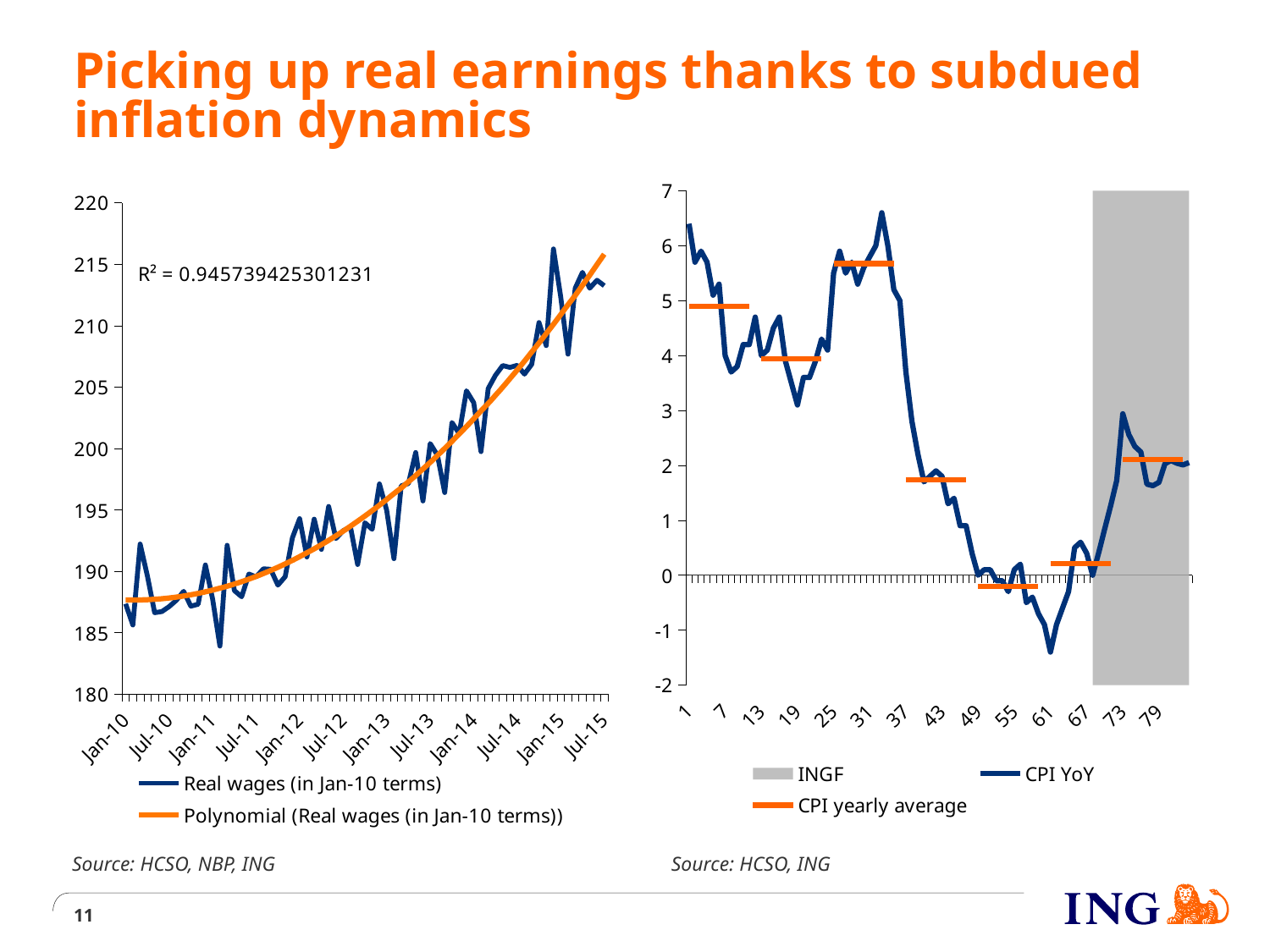
What kind of chart is the left chart showing real wages? Line chart In the right chart, is the CPI YoY value at point 1 greater or less than 6? greater What kind of chart is the right chart showing CPI YoY? Line chart In the right chart, is the lowest CPI YoY value greater or less than -1? less In the right chart, what does the grey shaded area represent according to the legend? INGF In the left chart, what R² value is printed on the chart? R² = 0.945739425301231 In the right chart, does CPI YoY overall rise or fall from the first point to the last point? Fall In the left chart, is the real wages value at Jan-10 greater or less than 190? less How many entries does the legend of the right chart list? 3 How many series does the legend of the left chart list? 2 In the left chart, do real wages generally rise or fall from Jan-10 to Jul-15? Rise